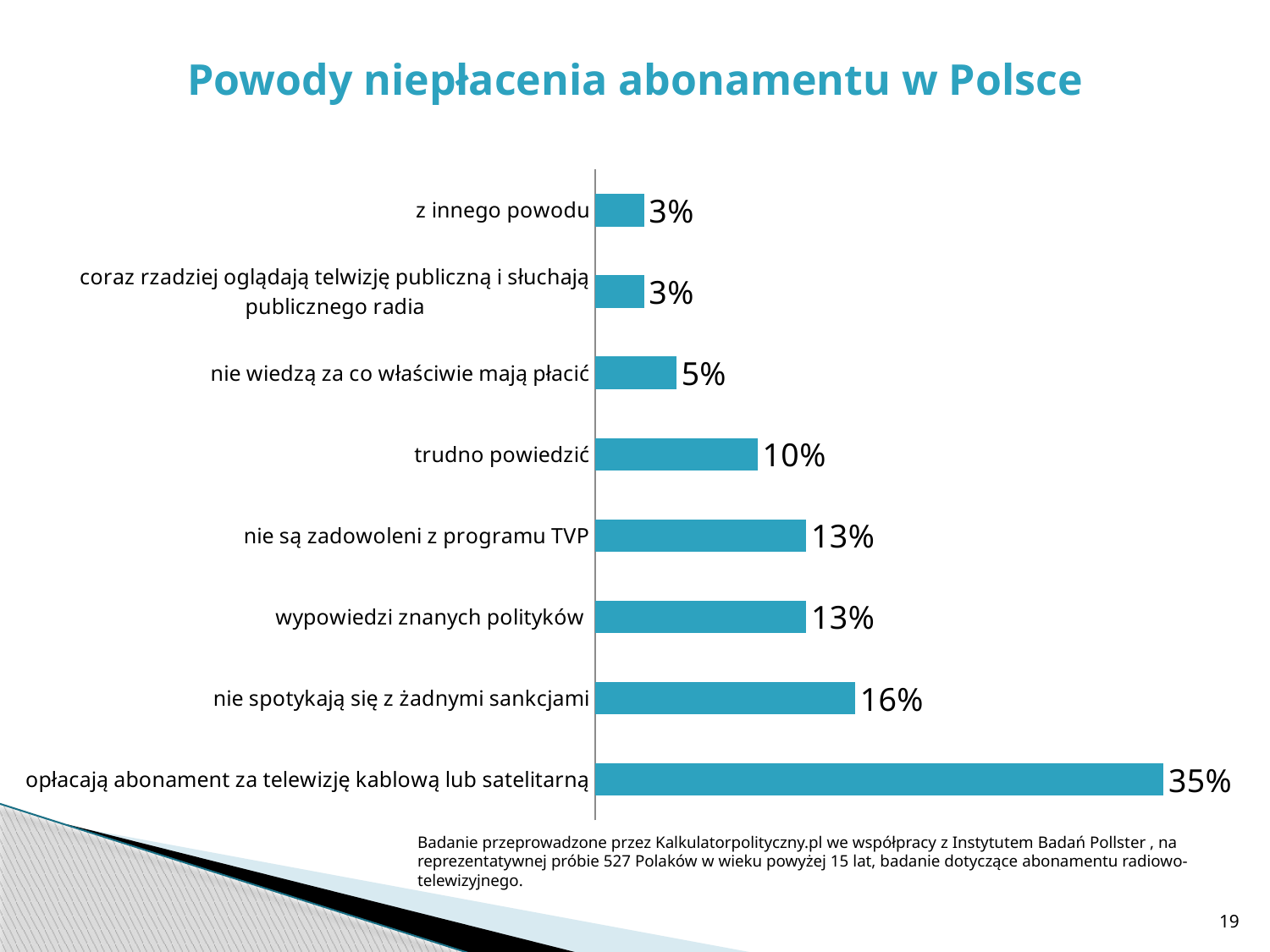
How many categories (reasons) are shown in the chart? 8 What percentage of respondents cite 'opłacają abonament za telewizję kablową lub satelitarną' as a reason? 35% What is the value for 'nie spotykają się z żadnymi sankcjami'? 16% What is the value for 'nie wiedzą za co właściwie mają płacić'? 5% What is the value for 'trudno powiedzić'? 10% What is the value for 'z innego powodu'? 3% Which reason has the highest percentage? opłacają abonament za telewizję kablową lub satelitarną What is the difference between 'nie są zadowoleni z programu TVP' and 'nie wiedzą za co właściwie mają płacić'? 8% What is the title of the slide? Powody niepłacenia abonamentu w Polsce Which is larger: the value for 'trudno powiedzić' or the value for 'wypowiedzi znanych polityków'? wypowiedzi znanych polityków What is the difference between the values for 'opłacają abonament za telewizję kablową lub satelitarną' and 'nie spotykają się z żadnymi sankcjami'? 19% What kind of chart is shown on the slide? bar chart